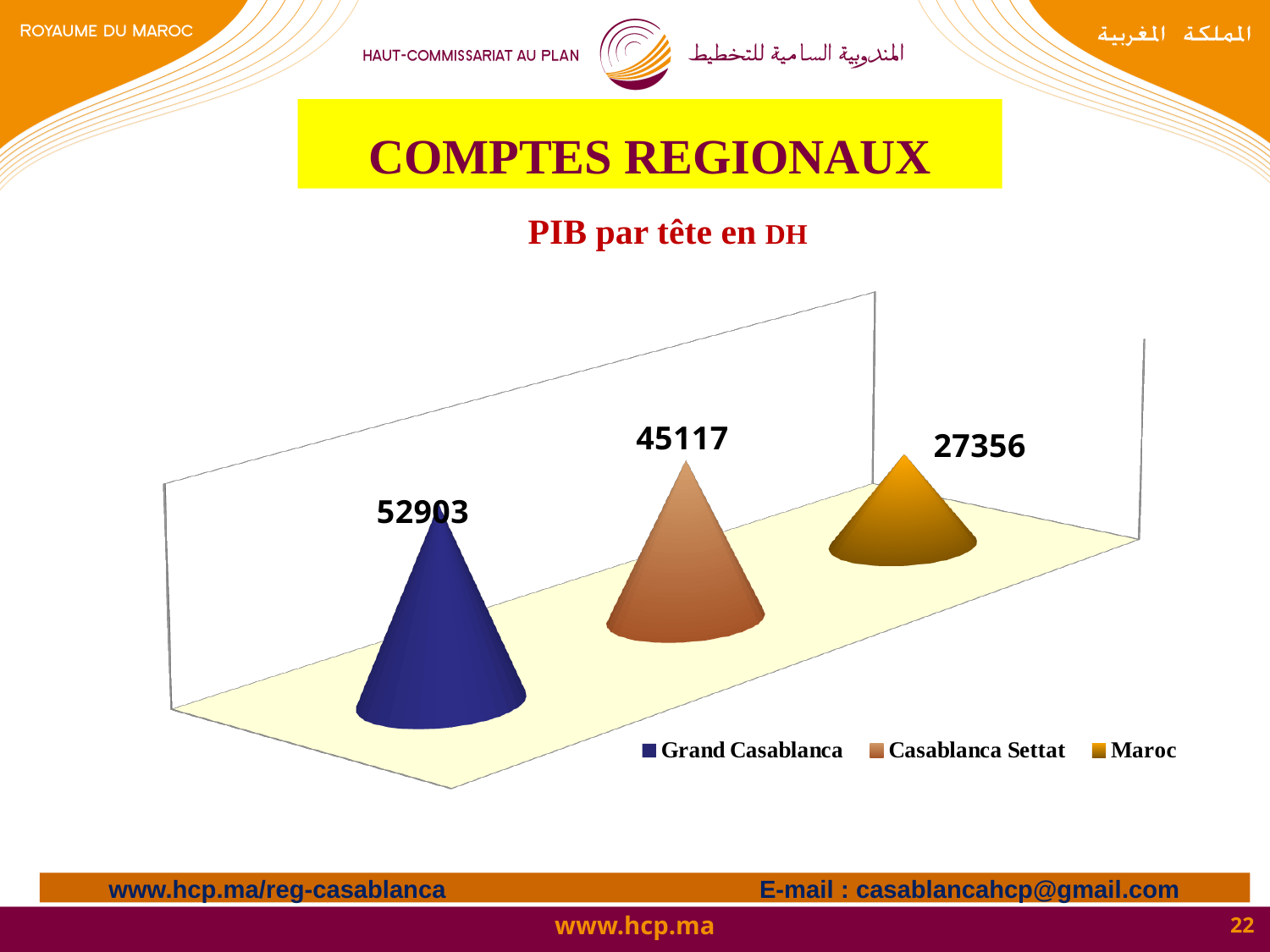
Which is larger, the PIB par tête of Casablanca Settat or of Maroc? Casablanca Settat What is the PIB par tête value for Grand Casablanca? 52903 Which series has the highest PIB par tête? Grand Casablanca What is the PIB par tête value for Casablanca Settat? 45117 Which series has the lowest PIB par tête? Maroc How many series does the legend list? 3 What is the difference between the PIB par tête of Grand Casablanca and Casablanca Settat? 7786 What is the title of the chart? PIB par tête en DH What is the PIB par tête value for Maroc? 27356 What colour represents Grand Casablanca in the chart? Blue What is the difference between the PIB par tête of Casablanca Settat and Maroc? 17761 What is the difference between the PIB par tête of Grand Casablanca and Maroc? 25547